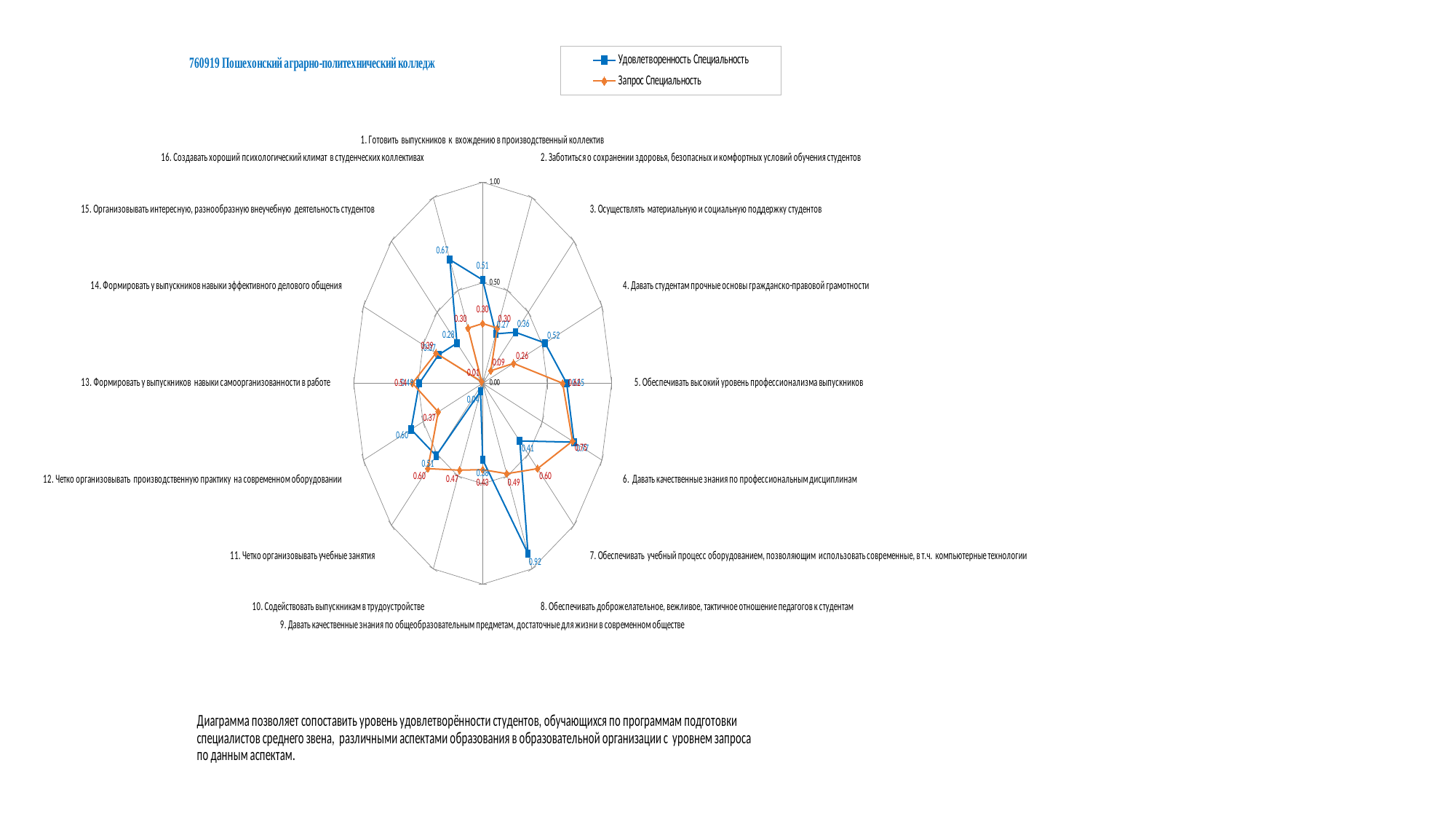
What is the value of the 'Запрос Специальность' series for category 8 (Обеспечивать доброжелательное, вежливое, тактичное отношение педагогов к студентам)? 0.49 What is the difference between the 'Удовлетворенность Специальность' and 'Запрос Специальность' values for category 8? 0.43 What is the value of the 'Запрос Специальность' series for category 1 (Готовить выпускников к вхождению в производственный коллектив)? 0.30 What is the title of the chart? 760919 Пошехонский аграрно-политехнический колледж What is the value of the 'Удовлетворенность Специальность' series for category 1 (Готовить выпускников к вхождению в производственный коллектив)? 0.51 How many categories (axes) does the radar chart have? 16 What type of chart is shown on the slide? Radar chart What is the value of the 'Удовлетворенность Специальность' series for category 16 (Создавать хороший психологический климат в студенческих коллективах)? 0.67 What is the value of the 'Удовлетворенность Специальность' series for category 8 (Обеспечивать доброжелательное, вежливое, тактичное отношение педагогов к студентам)? 0.92 For which category does the 'Удовлетворенность Специальность' series reach its highest value? 8. Обеспечивать доброжелательное, вежливое, тактичное отношение педагогов к студентам How many series does the legend list? 2 For category 9 (Давать качественные знания по общеобразовательным предметам), which series has the larger value: 'Удовлетворенность Специальность' (0.36) or 'Запрос Специальность' (0.43)? Запрос Специальность